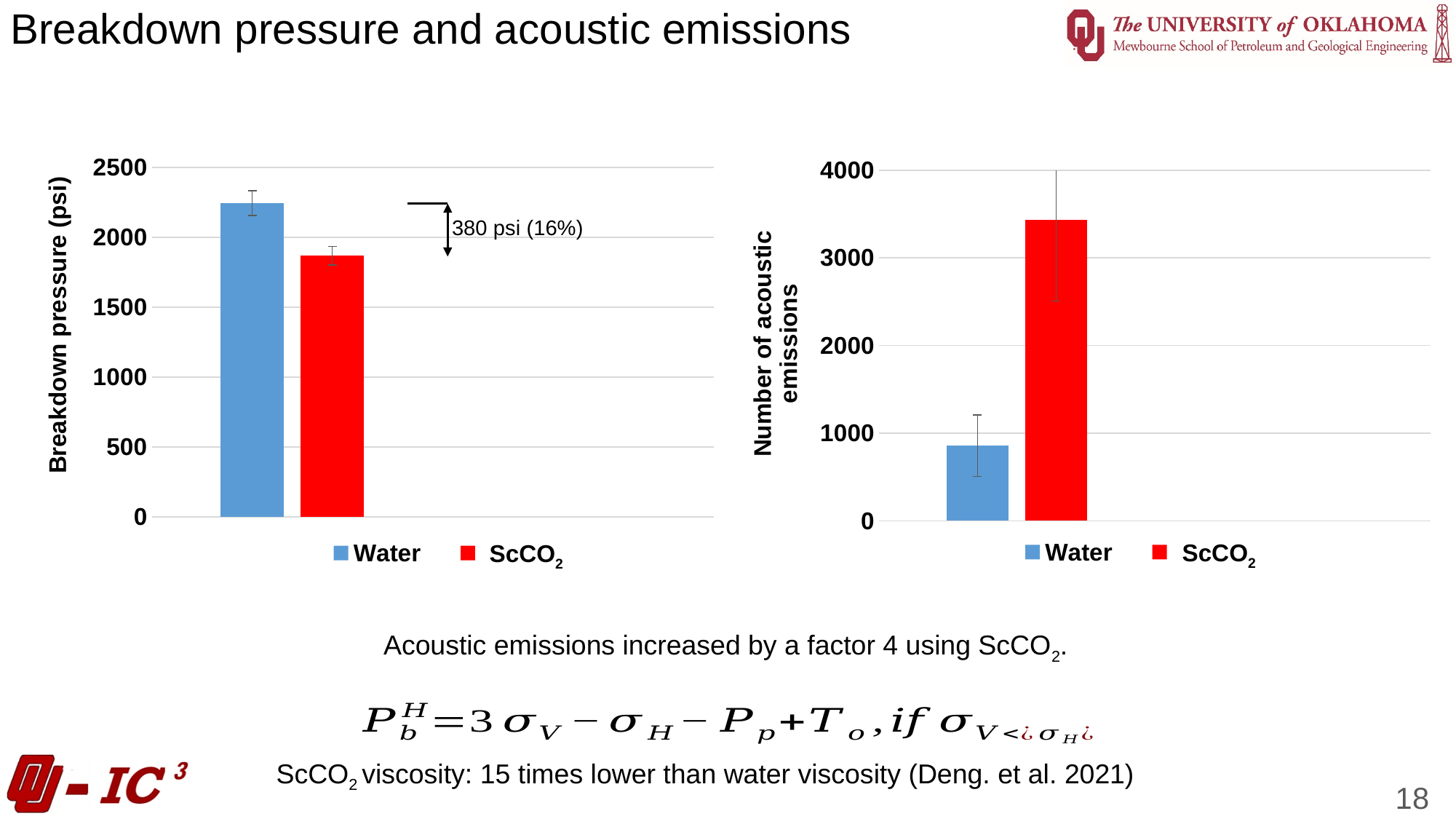
In the left chart (Breakdown pressure), which has the higher breakdown pressure, Water or ScCO2? Water In the right chart (Number of acoustic emissions), is the value for Water greater or less than 1000? less In the left chart (Breakdown pressure), which category has the lowest breakdown pressure? ScCO2 In the left chart (Breakdown pressure), is the value for Water greater or less than 2000? greater In the left chart (Breakdown pressure), what difference between the two bars is annotated on the chart? 380 psi (16%) How many series does the legend of the left chart (Breakdown pressure) list? 2 What is the y-axis label of the right chart? Number of acoustic emissions How many bars are plotted in the right chart (Number of acoustic emissions)? 2 In the left chart (Breakdown pressure), is the value for ScCO2 greater or less than 2000? less In the right chart (Number of acoustic emissions), which category has the highest number of acoustic emissions? ScCO2 What kind of chart is the left chart (Breakdown pressure)? bar chart